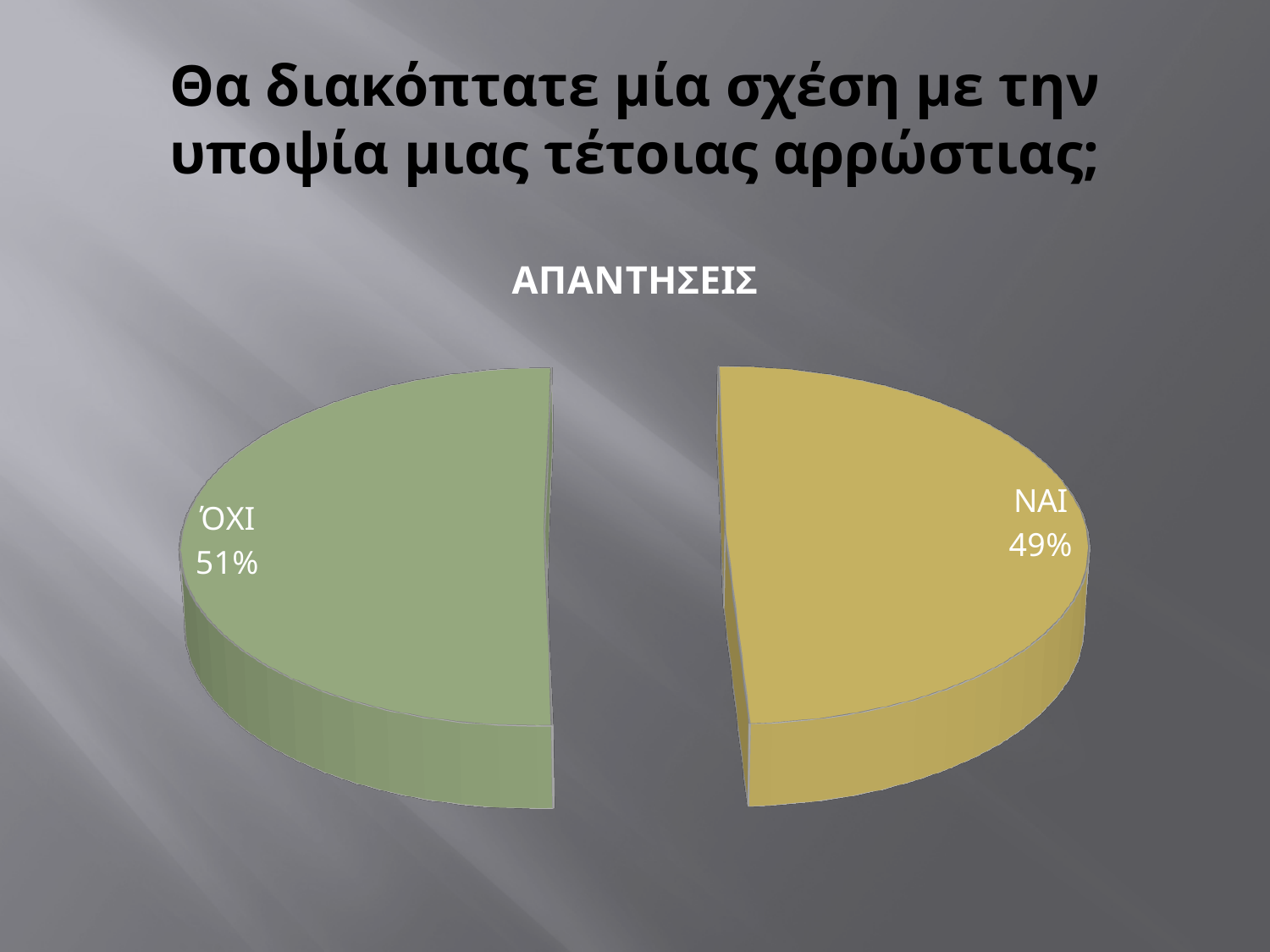
What share of the pie does ΝΑΙ represent? 49% What is the title of the chart? ΑΠΑΝΤΗΣΕΙΣ What share of the pie does ΌΧΙ represent? 51% What colour is the ΝΑΙ slice? yellow Which is larger, ΌΧΙ or ΝΑΙ? ΌΧΙ What kind of chart is shown on the slide? pie chart Which slice is the smallest? ΝΑΙ Which slice is the largest? ΌΧΙ What is the difference in percentage points between ΌΧΙ and ΝΑΙ? 2 How many slices does the pie chart have? 2